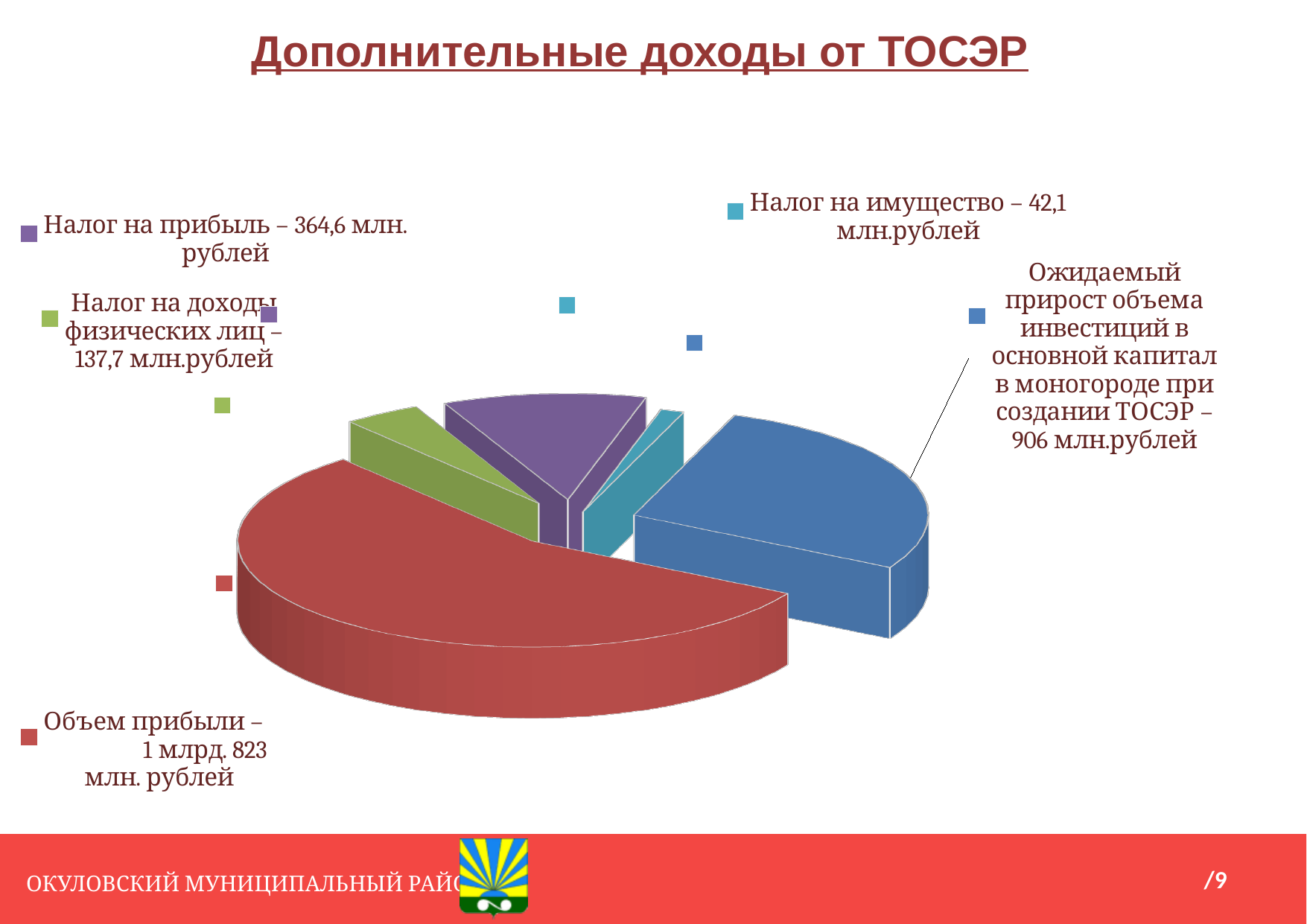
What is the value shown for «Налог на доходы физических лиц»? 137,7 млн.рублей What colour is the slice for «Объем прибыли»? Red What is the value shown for «Налог на прибыль»? 364,6 млн. рублей What is the value shown for the expected growth of investment in fixed capital («Ожидаемый прирост объема инвестиций в основной капитал»)? 906 млн.рублей Which category has the largest slice of the pie? Объем прибыли How many slices does the pie chart have? 5 What is the value shown for «Объем прибыли»? 1 млрд. 823 млн. рублей Which is larger: «Налог на прибыль» or «Налог на доходы физических лиц»? Налог на прибыль Which category has the smallest slice of the pie? Налог на имущество What kind of chart is shown on the slide? Pie chart What is the difference between «Налог на прибыль» and «Налог на доходы физических лиц» in млн. рублей? 226,9 What is the value shown for «Налог на имущество»? 42,1 млн.рублей